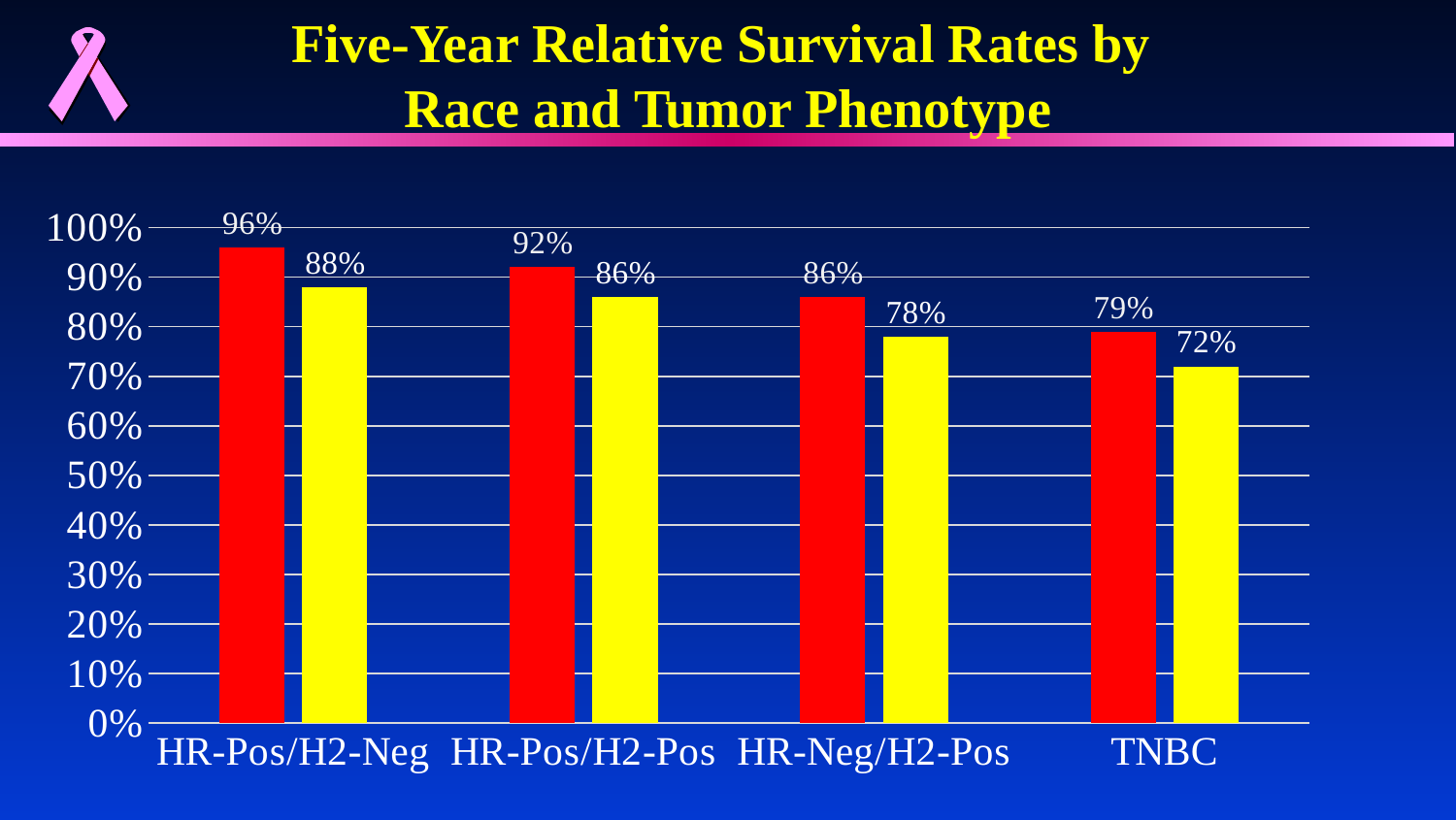
What is the value of the red bar for HR-Pos/H2-Neg? 96% What is the value of the yellow bar for TNBC? 72% What is the value of the yellow bar for HR-Neg/H2-Pos? 78% What is the difference between the red and yellow bars for HR-Neg/H2-Pos? 8% Which category has the highest red bar? HR-Pos/H2-Neg What is the value of the red bar for HR-Pos/H2-Pos? 92% Do the red bar values rise or fall from left to right across the categories? fall What is the difference between the red and yellow bars for HR-Pos/H2-Neg? 8% What kind of chart is shown on the slide? bar chart Which category has the lowest yellow bar? TNBC How many categories are shown on the x axis? 4 Which is larger, the red bar for TNBC or the yellow bar for HR-Neg/H2-Pos? the red bar for TNBC